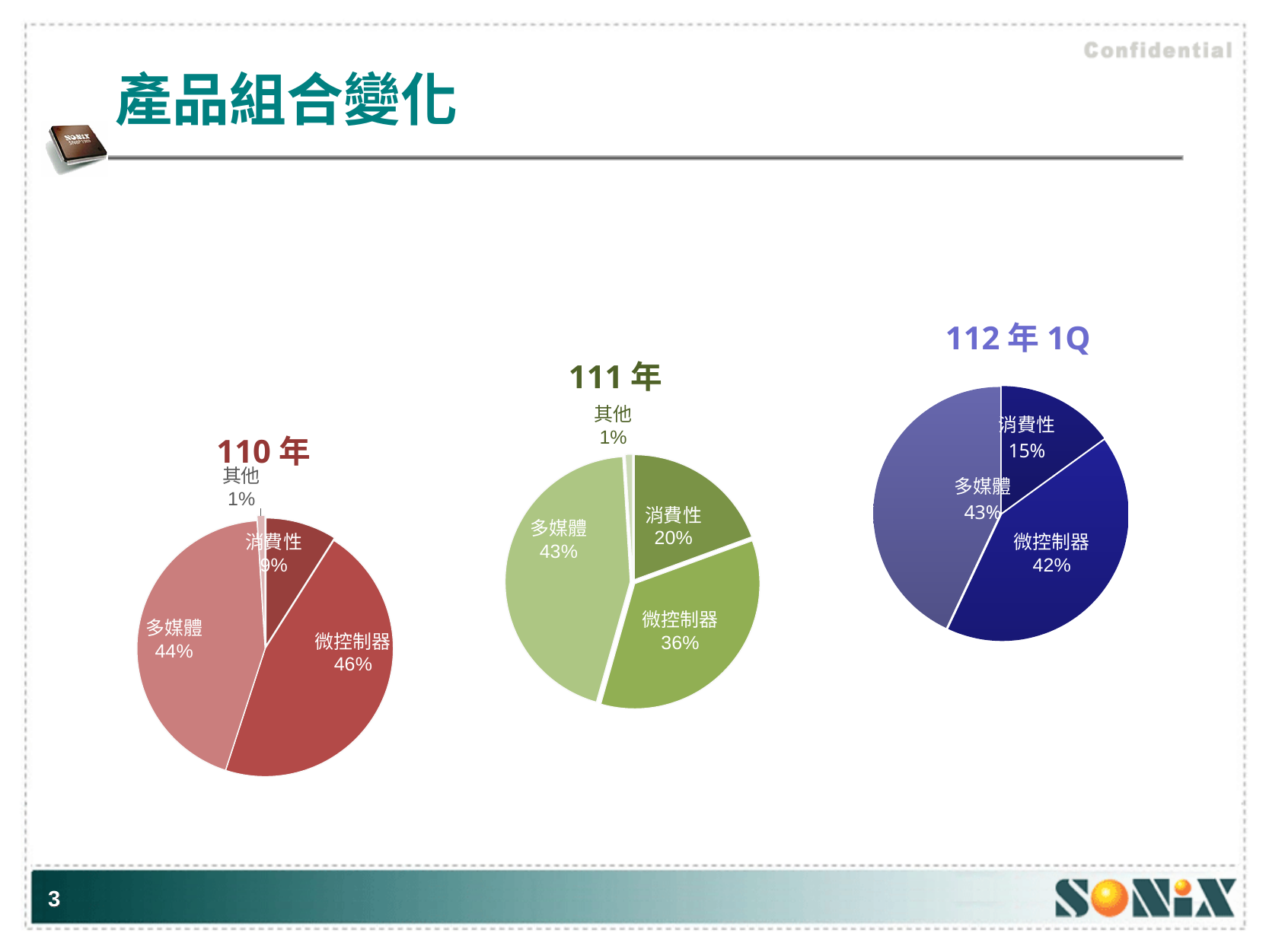
In the 110 年 pie chart, which category has the largest share? 微控制器 In the 110 年 pie chart, what share does 微控制器 have? 46% How many pie charts are shown on the slide? 3 In the 110 年 pie chart, which is larger, the share of 消費性 or the share of 多媒體? 多媒體 In the 111 年 pie chart, what share does 消費性 have? 20% How many labelled slices does the 112 年 1Q pie chart have? 3 In the 111 年 pie chart, which category has the largest share? 多媒體 What kind of chart is used for 110 年? Pie chart In the 111 年 pie chart, which category has the smallest share? 其他 In the 112 年 1Q pie chart, what share does 多媒體 have? 43% In the 111 年 pie chart, what is the difference between the shares of 多媒體 and 微控制器? 7% In the 112 年 1Q pie chart, which category has the smallest share? 消費性